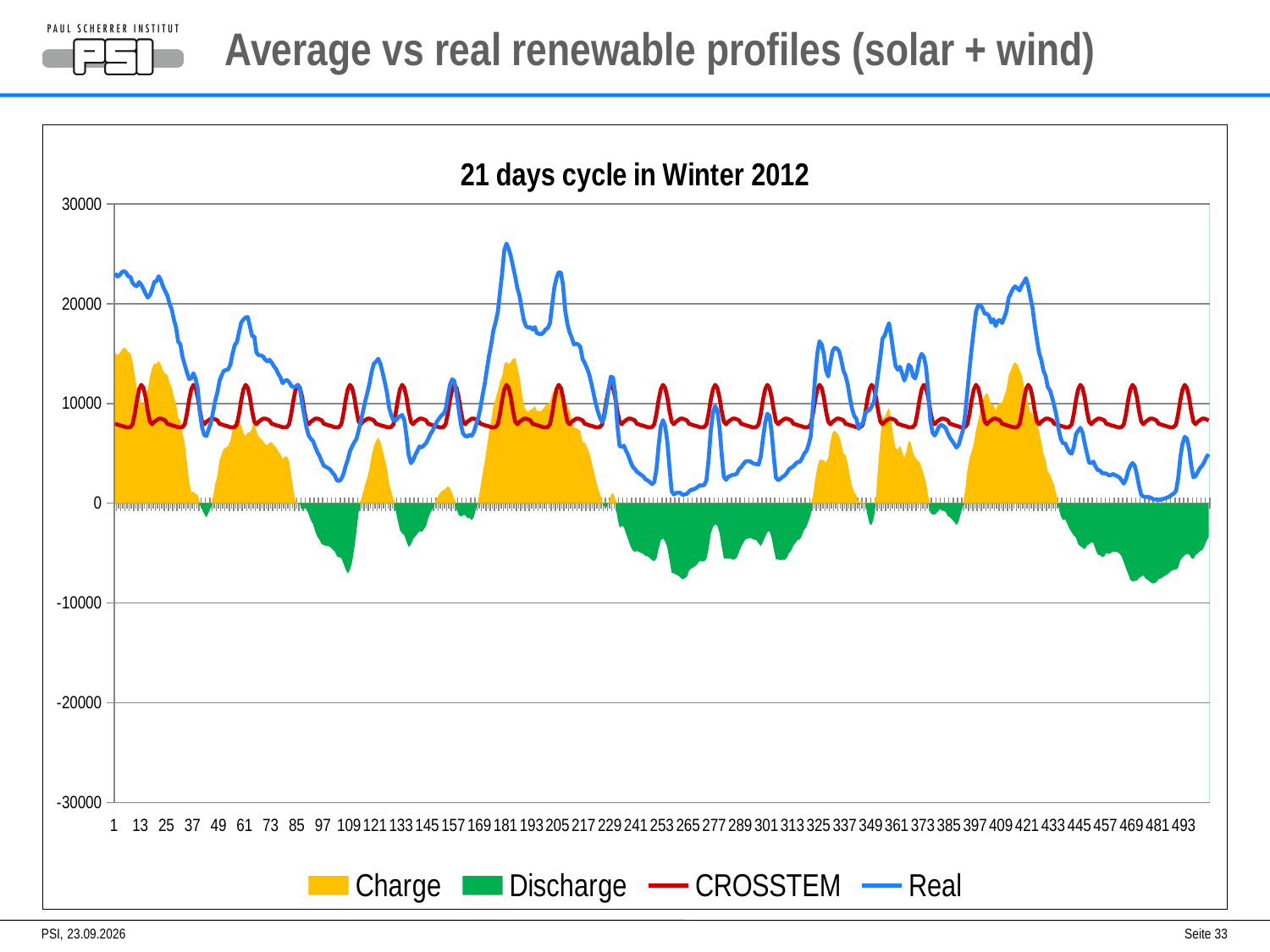
How many series does the legend list? 4 How many tick labels are shown on the x axis? 42 Is the highest value reached by the Real series greater or less than 20000? greater Is the value of the Real series at x = 481 greater or less than 10000? less What kind of chart is shown? combination of area and line chart What is the title of the chart? 21 days cycle in Winter 2012 Is the lowest value of the Discharge series greater or less than -10000? greater Which series is drawn as a red line? CROSSTEM Which series reaches higher values overall, Real or CROSSTEM? Real